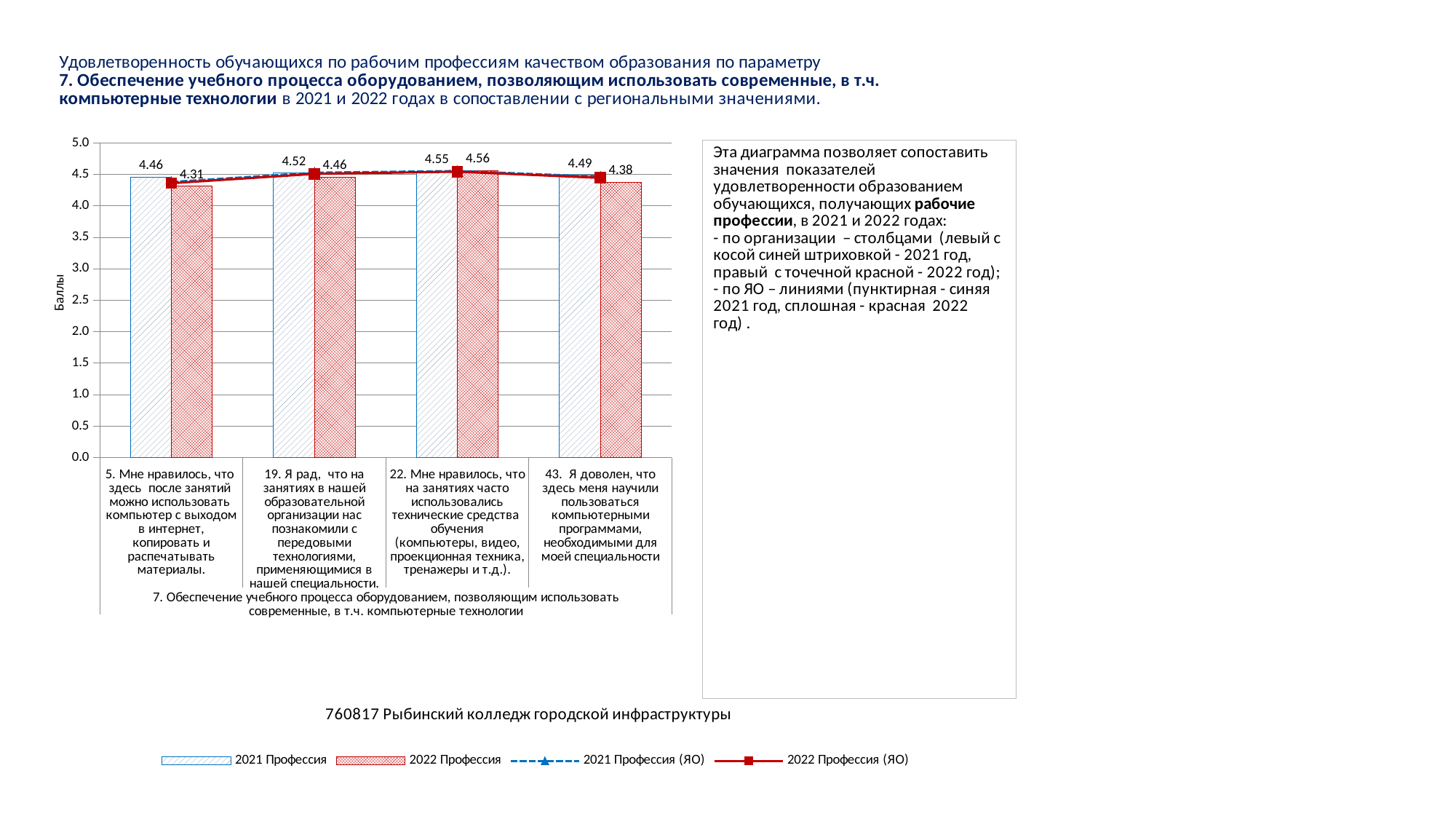
Which statement has the highest 2021 Профессия value? 22. Мне нравилось, что на занятиях часто использовались технические средства обучения For statement 43, which is larger: the 2021 Профессия value or the 2022 Профессия value? 2021 Профессия What is the value of the 2022 Профессия bar for statement 43 (learning to use computer programs needed for my specialty)? 4.38 What is the label of the vertical axis? Баллы What kind of chart is shown on the slide? bar chart (with line series) What is the value of the 2022 Профессия bar for statement 19 (being introduced to advanced technologies)? 4.46 What is the value of the 2021 Профессия bar for statement 5 (using a computer with internet access after classes)? 4.46 How many statements (categories) are shown on the x axis? 4 Is the 2022 Профессия (ЯО) line value for statement 5 greater or less than 4.0? greater What is the difference between the 2021 Профессия and 2022 Профессия values for statement 5? 0.15 How many series does the legend list? 4 Which statement has the lowest 2022 Профессия value? 5. Мне нравилось, что здесь после занятий можно использовать компьютер с выходом в интернет